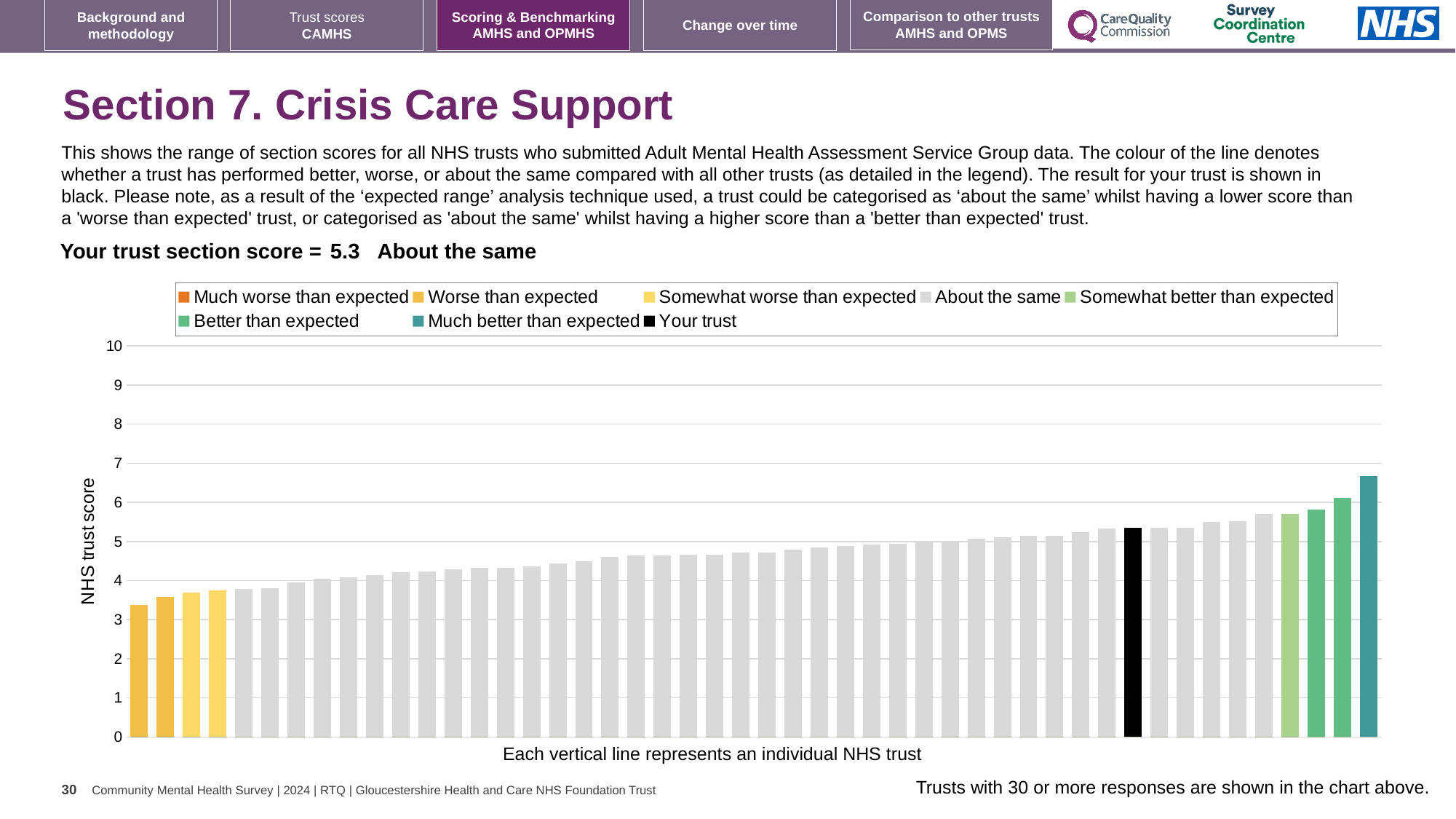
What colour is used for the bar representing your trust? black What kind of chart is shown on the slide? bar chart What is the section score for your trust shown on the slide? 5.3 Is the value for your trust (black bar) greater or less than 5? greater Which legend category does the tallest bar belong to? Much better than expected Do the bar values rise or fall from left to right across the chart? rise What is the label on the vertical axis of the chart? NHS trust score Is the value of the shortest bar greater or less than 4? less Is the value of the tallest bar greater or less than 6? greater How many entries does the chart legend list? 8 How is your trust categorised compared with other trusts? About the same Which legend category does the shortest bar belong to? Worse than expected